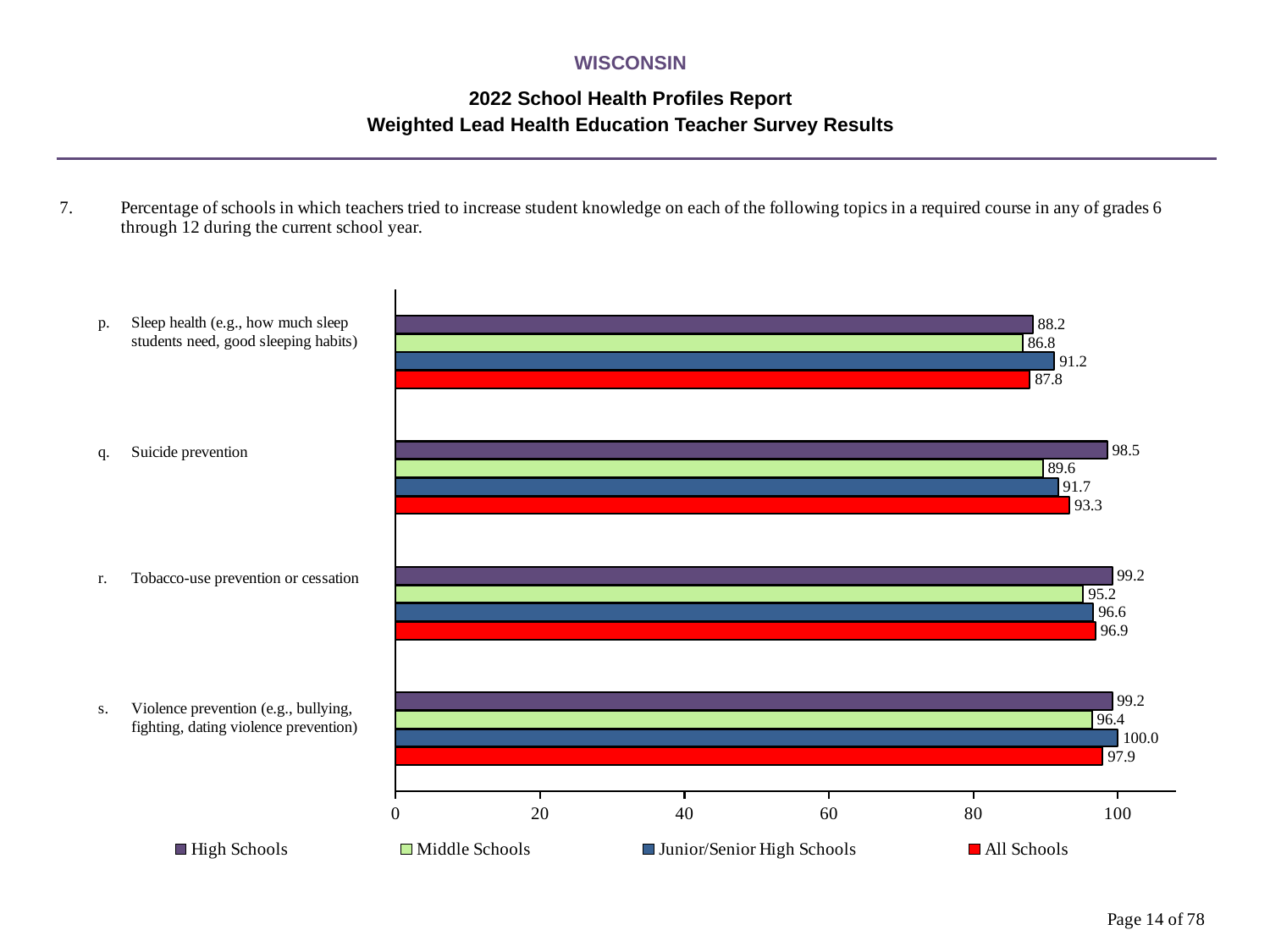
Which topic has the lowest value for All Schools? Sleep health Which topic has the highest value for Middle Schools? Violence prevention What is the value for All Schools for Tobacco-use prevention or cessation? 96.9 What is the value for High Schools for Suicide prevention? 98.5 What kind of chart is shown on the slide? Bar chart What is the value for Middle Schools for Sleep health? 86.8 What is the value for Junior/Senior High Schools for Violence prevention? 100.0 How many series does the legend list? 4 What is the difference between the High Schools and Middle Schools values for Suicide prevention? 8.9 How many topics are shown on the chart? 4 Which series is shown in red in the legend? All Schools Which is larger for Sleep health: the Junior/Senior High Schools value or the All Schools value? Junior/Senior High Schools